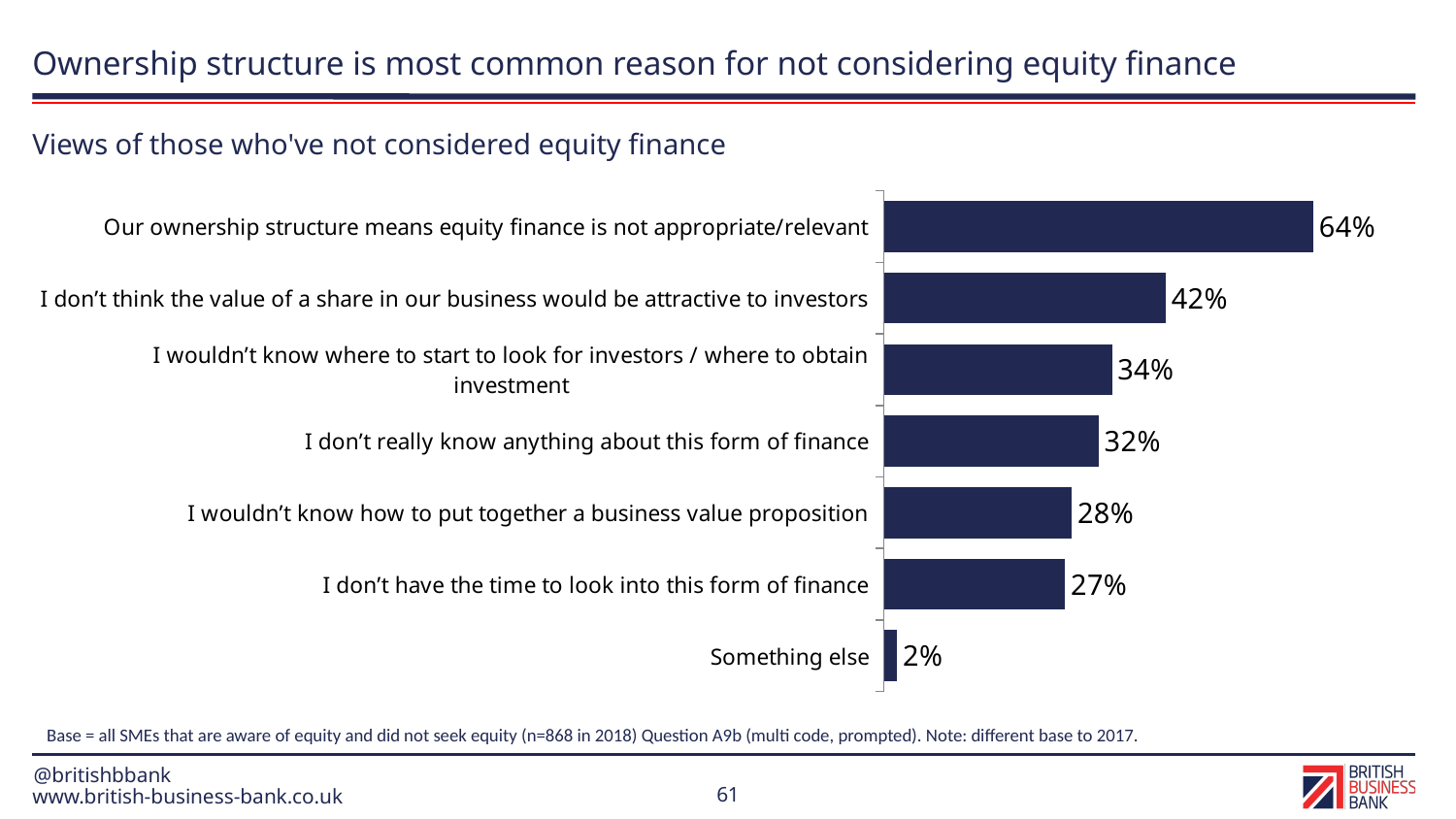
Which category has the lowest value? Something else How many categories are shown in the chart? 7 What is the difference between the value for "I don't think the value of a share in our business would be attractive to investors" and "I wouldn't know where to start to look for investors / where to obtain investment"? 8% What is the difference between the highest and lowest values in the chart? 62% What kind of chart is shown on the slide? Bar chart What is the value for "I don't really know anything about this form of finance"? 32% Which is larger: the value for "I wouldn't know how to put together a business value proposition" or "I don't have the time to look into this form of finance"? I wouldn't know how to put together a business value proposition What is the subtitle of the chart? Views of those who've not considered equity finance What is the sample size (n) given in the base note below the chart? n=868 Which reason has the highest percentage? Our ownership structure means equity finance is not appropriate/relevant What percentage said they don't have the time to look into this form of finance? 27% What percentage of respondents said their ownership structure means equity finance is not appropriate/relevant? 64%